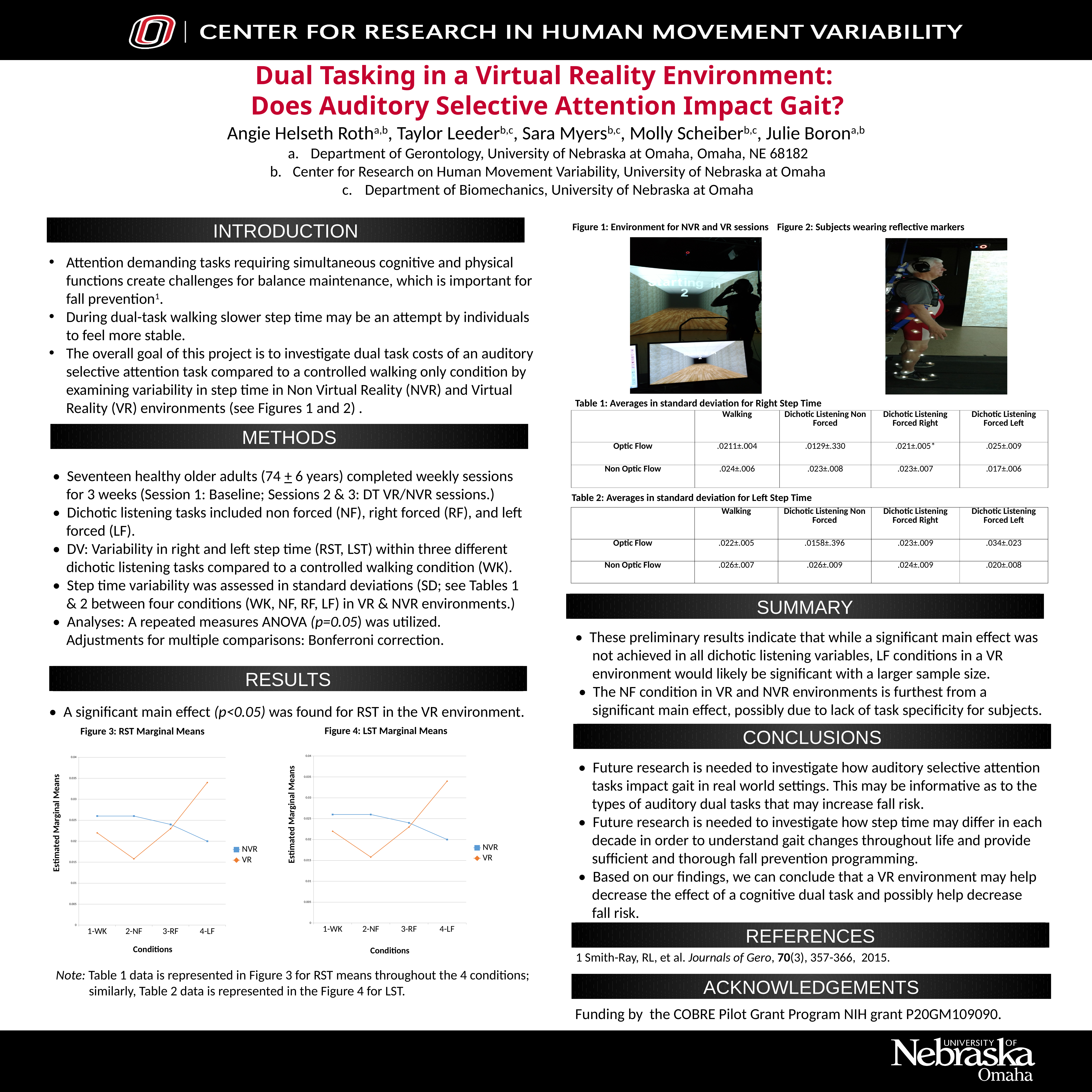
In Figure 3: RST Marginal Means, at condition 4-LF, which series has the larger value, NVR or VR? VR In Figure 3: RST Marginal Means, is the VR value at 2-NF greater or less than 0.02? less In Figure 4: LST Marginal Means, does the VR series rise or fall from 2-NF to 4-LF? rise In Figure 4: LST Marginal Means, at which condition is the VR series lowest? 2-NF In Figure 4: LST Marginal Means, at condition 2-NF, which series has the larger value, NVR or VR? NVR In Figure 3: RST Marginal Means, at which condition is the VR series highest? 4-LF In Figure 3: RST Marginal Means, what is the label of the y axis? Estimated Marginal Means In Figure 4: LST Marginal Means, is the VR value at 4-LF greater or less than 0.03? greater In Figure 3: RST Marginal Means, what kind of chart is shown? line chart In Figure 3: RST Marginal Means, how many conditions are plotted along the x axis? 4 In Figure 3: RST Marginal Means, at which condition is the NVR series lowest? 4-LF In Figure 4: LST Marginal Means, how many series does the legend list? 2